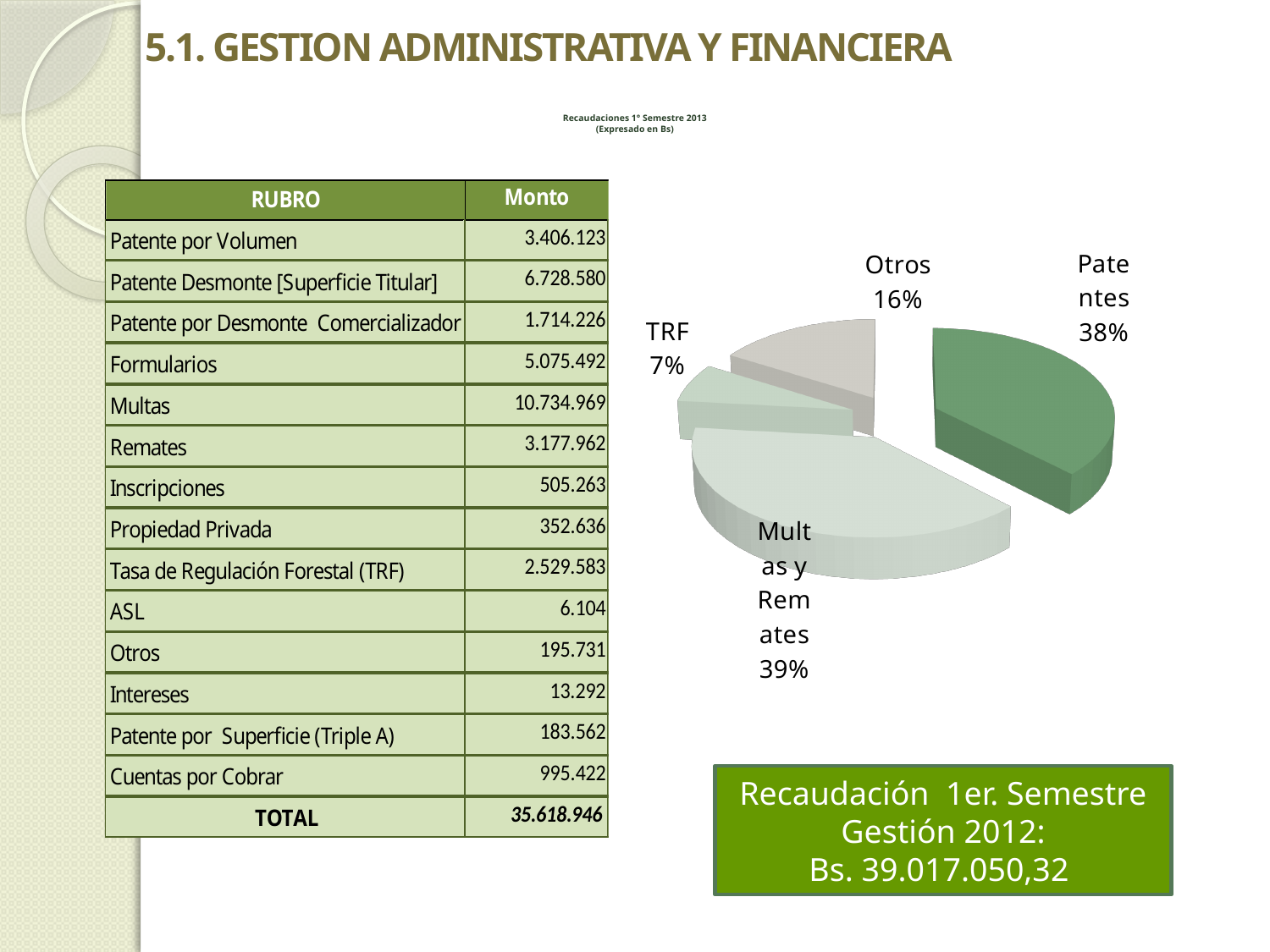
What percentage is shown for the TRF slice? 7% What is the difference in percentage points between the Patentes slice and the Otros slice? 22 What share of the pie does the Patentes slice represent? 38% What is the title of the pie chart? Recaudaciones 1° Semestre 2013 (Expresado en Bs) How many slices does the pie chart have? 4 What share of the pie does the Multas y Remates slice represent? 39% What percentage is shown for the Otros slice? 16% Which slice of the pie chart has the largest share? Multas y Remates What kind of chart is shown on the slide? pie chart Which slice of the pie chart has the smallest share? TRF Which slice is larger, Otros or TRF? Otros What is the difference in percentage points between the Multas y Remates slice and the TRF slice? 32